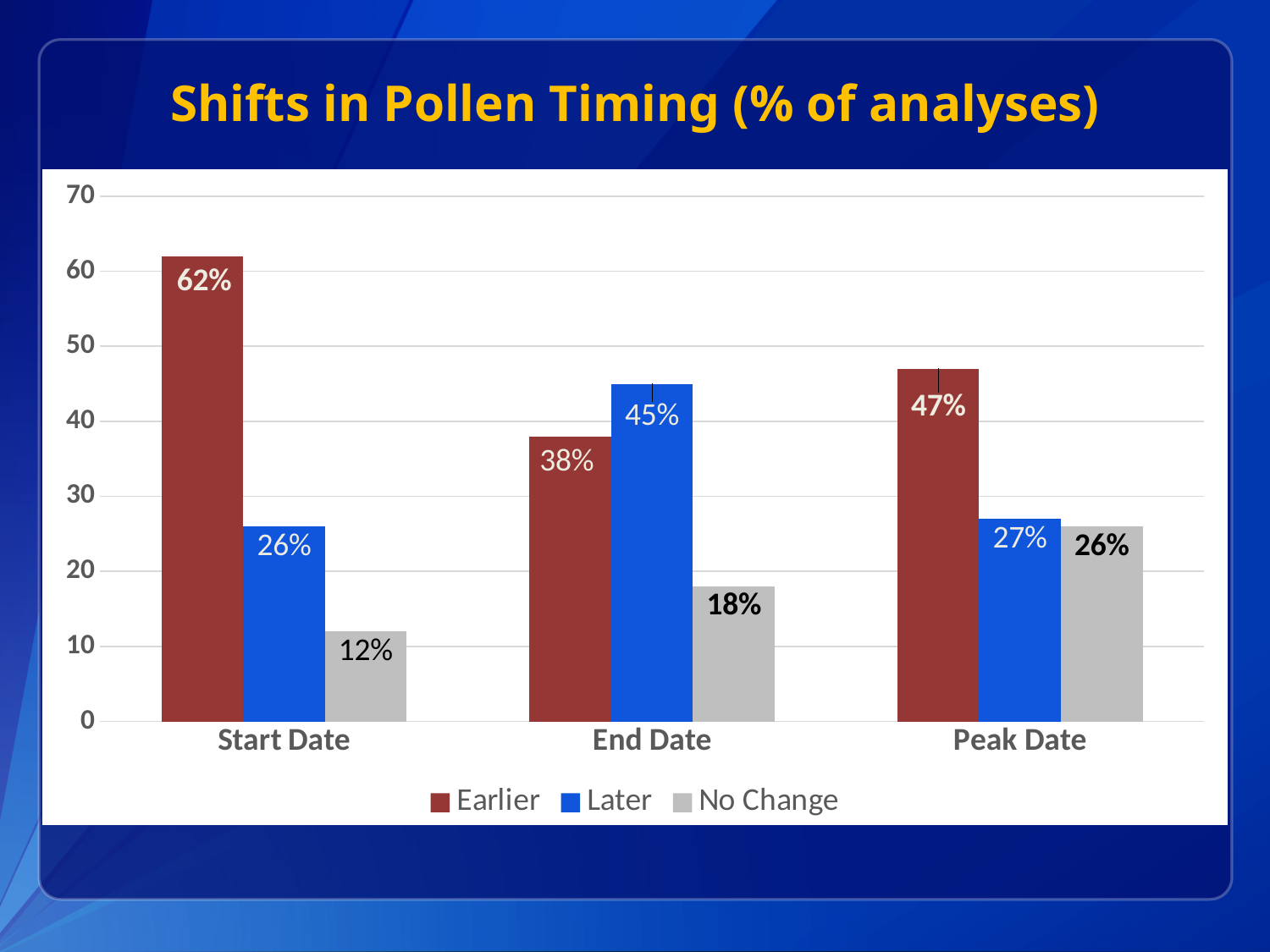
What is the value for Later at End Date? 45% How many series does the legend list? 3 Is the value for Earlier at Peak Date greater or less than 40? greater What is the value for Earlier at Start Date? 62% What is the difference between the Earlier and Later values at Start Date? 36% At End Date, which is larger: Earlier or Later? Later What is the title of the chart? Shifts in Pollen Timing (% of analyses) How many categories are shown on the x axis? 3 What is the value for No Change at Peak Date? 26% Which category has the highest value for the Earlier series? Start Date Which category has the lowest value for the No Change series? Start Date What kind of chart is shown on the slide? bar chart